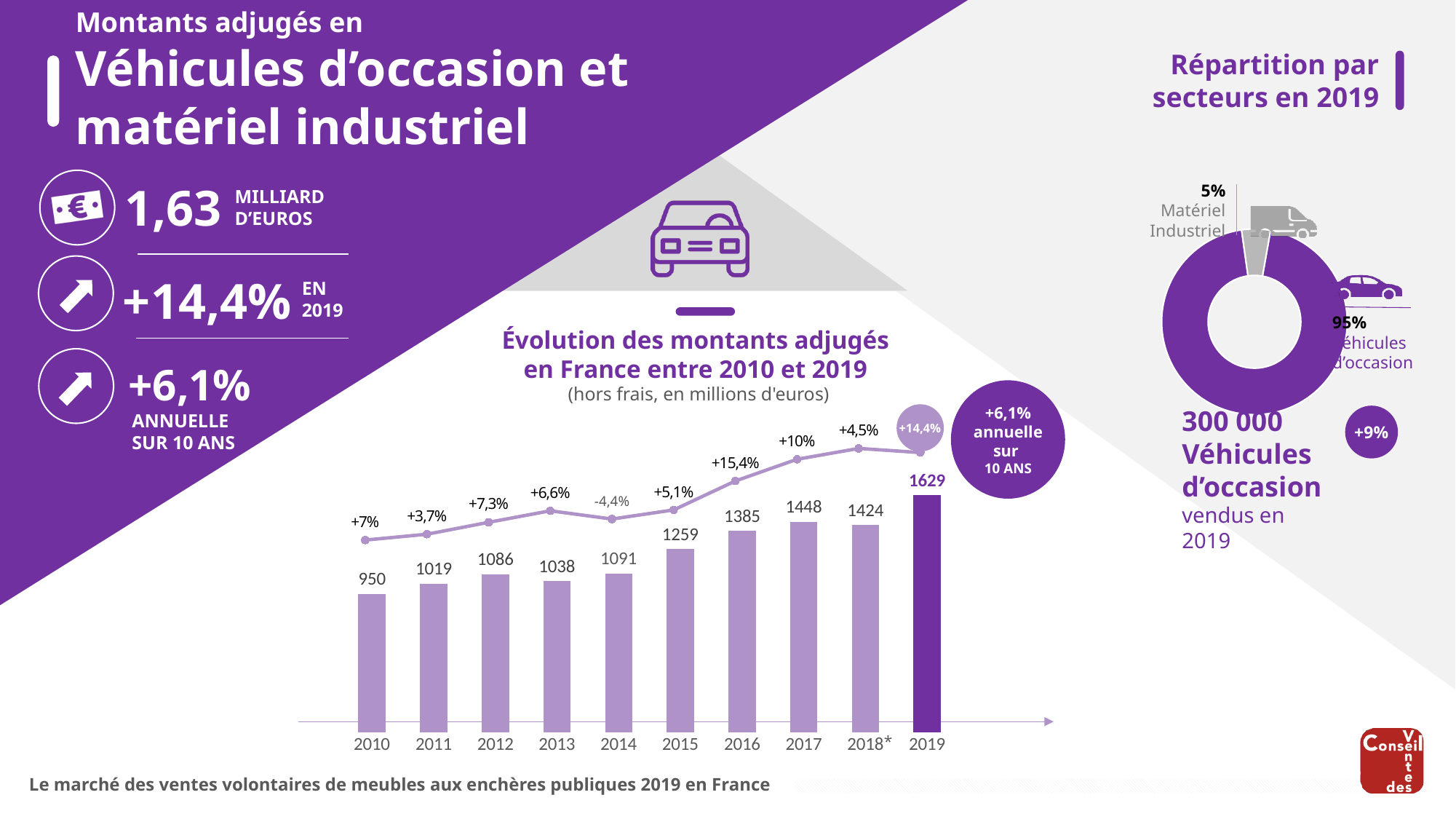
In the chart 'Évolution des montants adjugés en France entre 2010 et 2019', which is larger, the value for 2013 or the value for 2014? 2014 In the chart 'Évolution des montants adjugés en France entre 2010 et 2019', what is the value for 2015? 1259 In the chart 'Évolution des montants adjugés en France entre 2010 et 2019', what is the value for 2010? 950 What kind of chart is 'Répartition par secteurs en 2019'? Donut (pie) chart In the chart 'Évolution des montants adjugés en France entre 2010 et 2019', what growth rate is shown on the line for 2016? +15,4% In the chart 'Évolution des montants adjugés en France entre 2010 et 2019', what is the difference between the values for 2019 and 2018*? 205 In the chart 'Évolution des montants adjugés en France entre 2010 et 2019', how many years are shown on the x axis? 10 In the chart 'Évolution des montants adjugés en France entre 2010 et 2019', which year has the lowest value? 2010 In the chart 'Évolution des montants adjugés en France entre 2010 et 2019', which year has the highest value? 2019 In the chart 'Évolution des montants adjugés en France entre 2010 et 2019', what is the value for 2019? 1629 In the chart 'Répartition par secteurs en 2019', what share does Matériel Industriel represent? 5% In the chart 'Évolution des montants adjugés en France entre 2010 et 2019', what growth rate is shown on the line for 2014? -4,4%